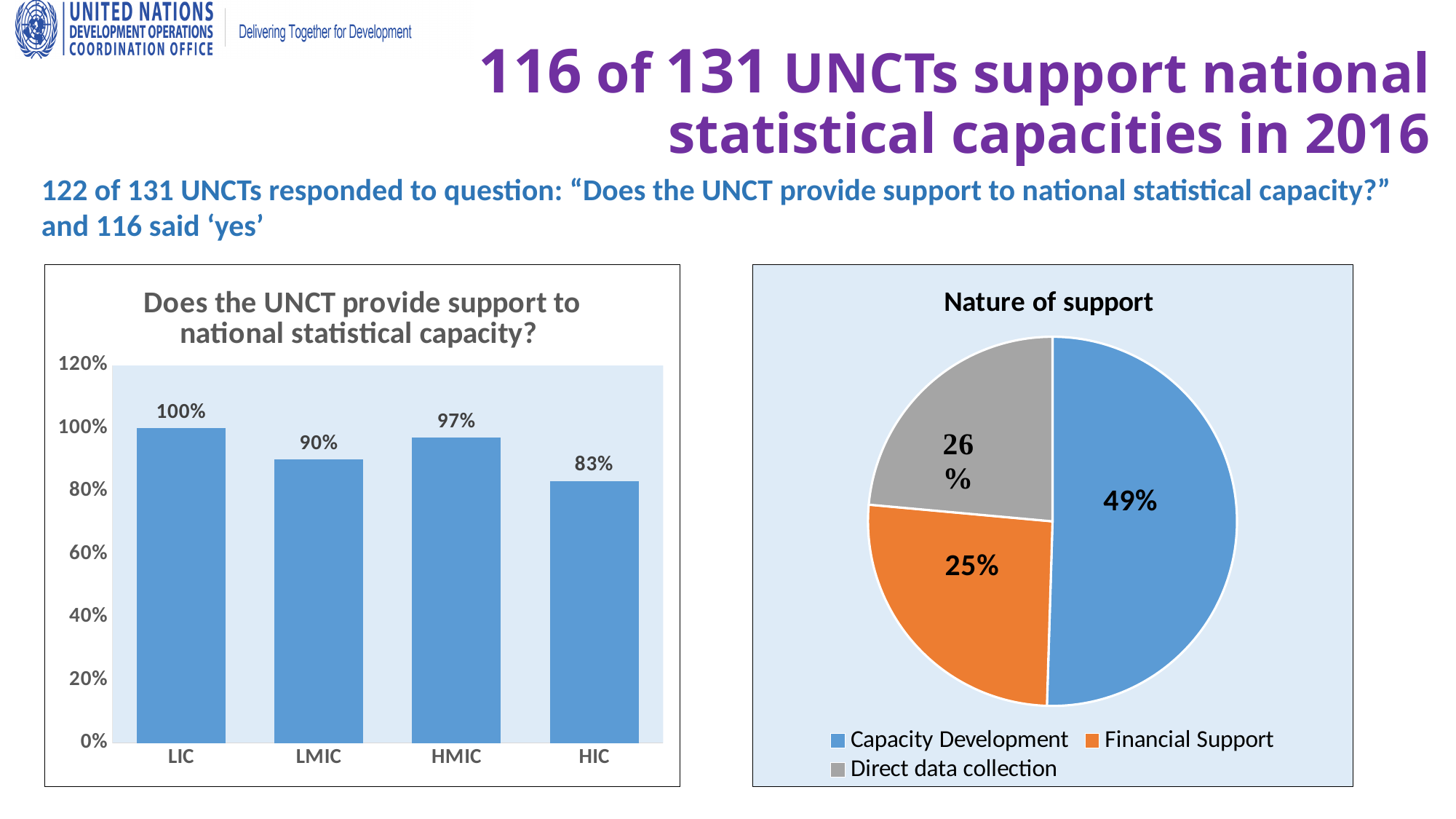
In the chart titled "Does the UNCT provide support to national statistical capacity?", which category has the highest value? LIC In the chart titled "Does the UNCT provide support to national statistical capacity?", what is the value for LMIC? 90% What kind of chart is the chart titled "Does the UNCT provide support to national statistical capacity?"? bar chart How many entries does the legend of the "Nature of support" chart list? 3 In the "Nature of support" chart, what share does Financial Support have? 25% In the chart titled "Does the UNCT provide support to national statistical capacity?", what is the difference between the values for LIC and HIC? 17% In the chart titled "Does the UNCT provide support to national statistical capacity?", which category has the lowest value? HIC In the "Nature of support" chart, which category has the largest slice? Capacity Development In the "Nature of support" chart, what share does Capacity Development have? 49% In the chart titled "Does the UNCT provide support to national statistical capacity?", what is the value for HIC? 83% In the chart titled "Does the UNCT provide support to national statistical capacity?", which is larger, the value for LMIC or the value for HMIC? HMIC In the chart titled "Does the UNCT provide support to national statistical capacity?", how many categories are shown on the x axis? 4